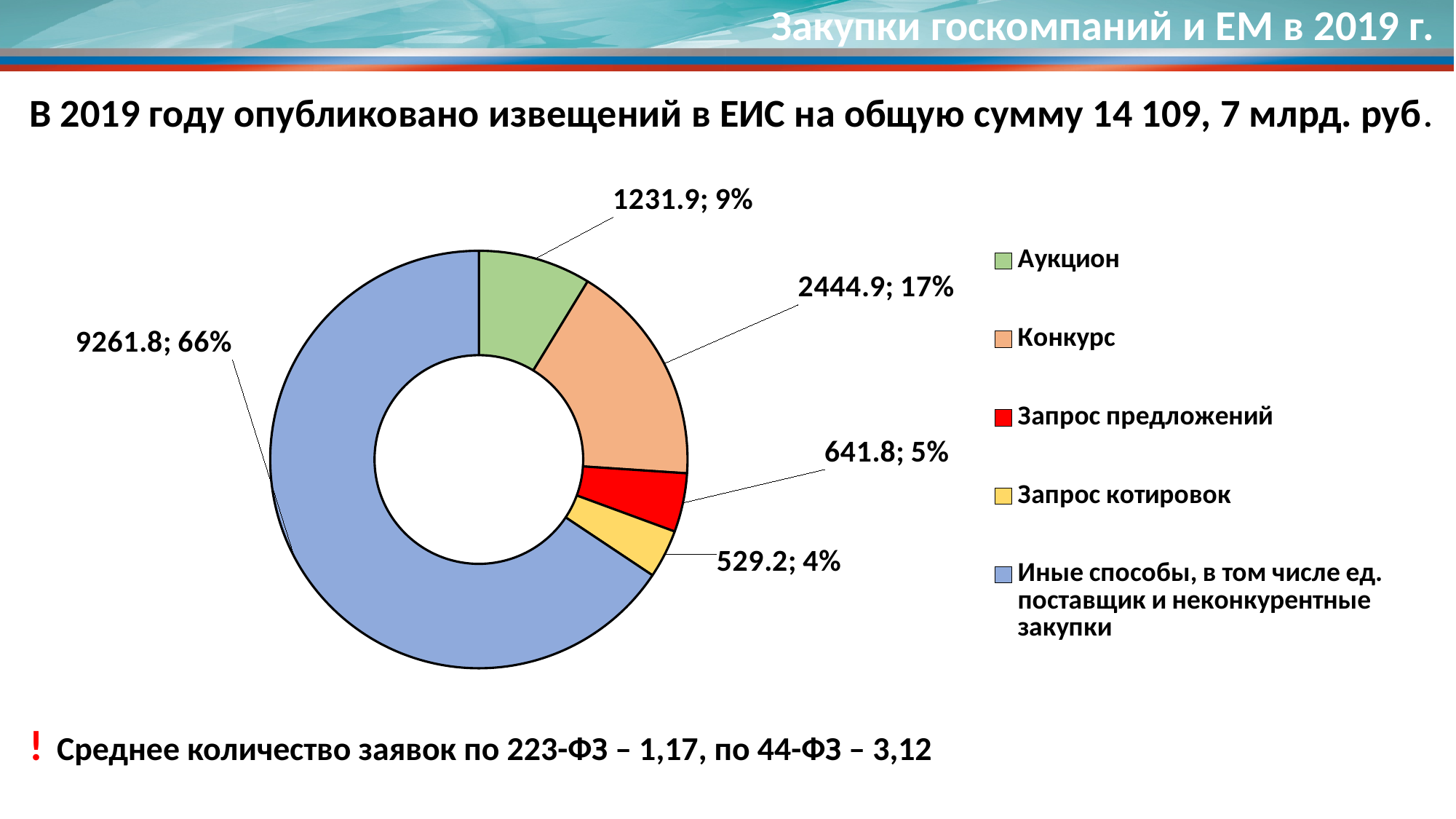
What is the difference between the values for Конкурс and Аукцион? 1213.0 Which is larger, the value for Запрос предложений or the value for Запрос котировок? Запрос предложений How many categories does the chart show? 5 Which category has the largest value? Иные способы, в том числе ед. поставщик и неконкурентные закупки What is the value for Аукцион? 1231.9 What share of the chart does Конкурс represent? 17% What is the value for Запрос котировок? 529.2 What is the value for Конкурс? 2444.9 What share of the chart does the category 'Иные способы, в том числе ед. поставщик и неконкурентные закупки' represent? 66% What kind of chart is shown on the slide? Doughnut (pie) chart Which category has the smallest value? Запрос котировок What is the value for Запрос предложений? 641.8